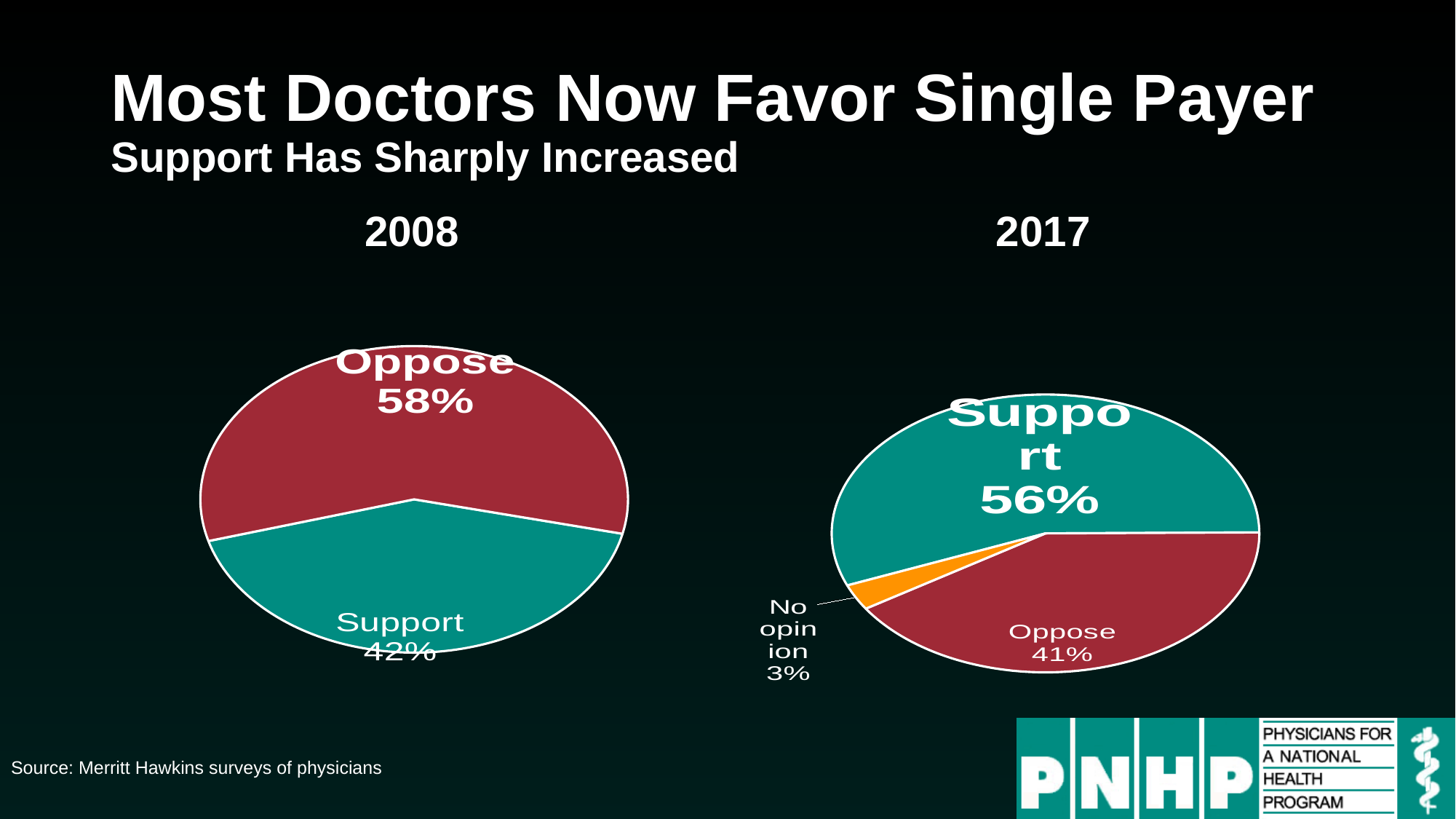
In the 2017 pie chart, which slice is the smallest? No opinion How many slices does the 2017 pie chart have? 3 In the 2017 pie chart, which is larger, Support or Oppose? Support What type of chart is used on this slide? Pie chart What is the difference between the Oppose share in 2008 and the Oppose share in 2017? 17 percentage points In the 2017 pie chart, what share of doctors supported single payer? 56% What colour is the Support slice in both pie charts? Teal In the 2008 pie chart, which slice is the largest? Oppose In the 2017 pie chart, what share of doctors opposed single payer? 41% In the 2008 pie chart, what share of doctors supported single payer? 42% In the 2017 pie chart, what share of doctors had no opinion? 3% In the 2008 pie chart, what share of doctors opposed single payer? 58%